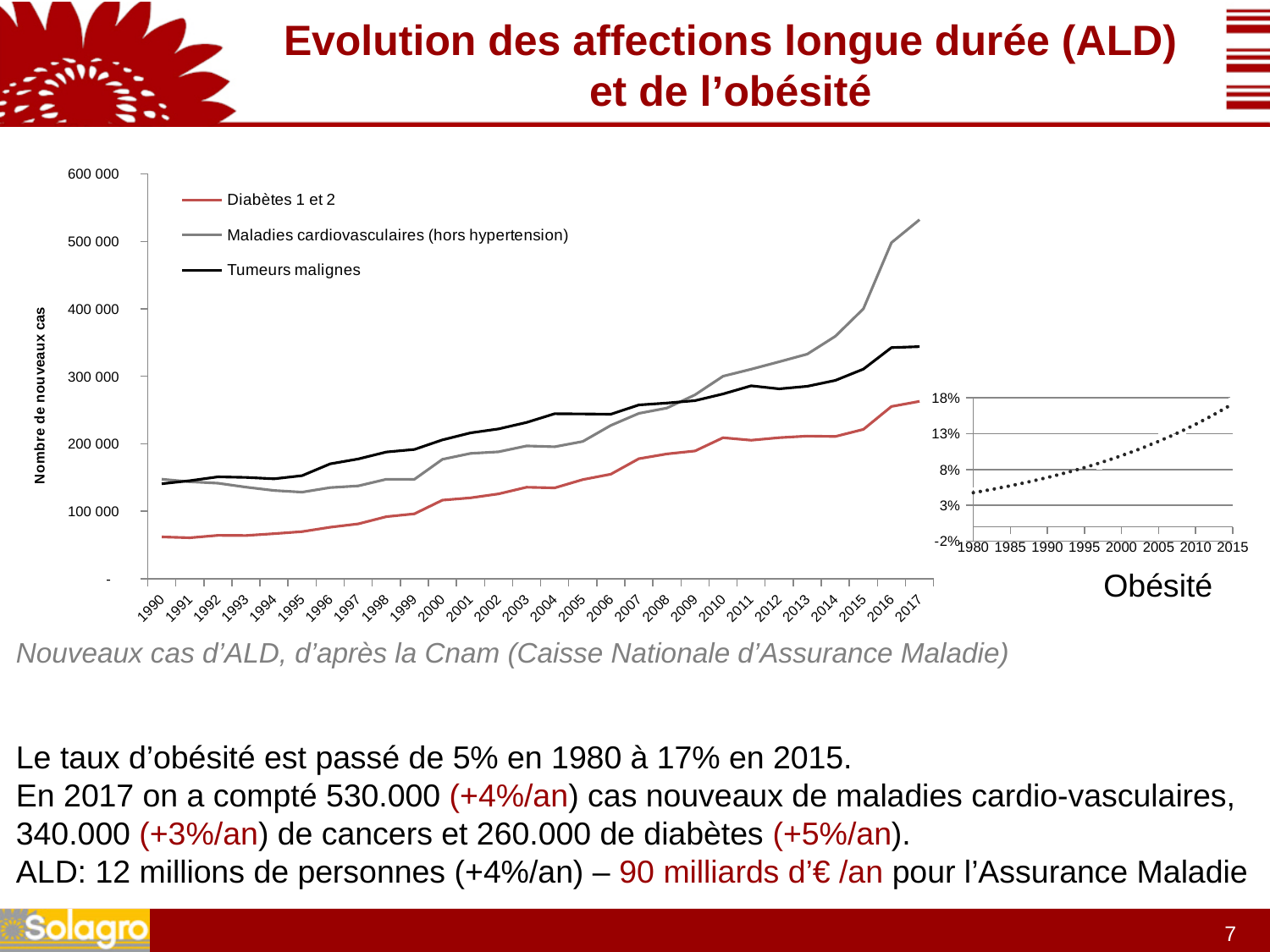
On the large chart on the left, what kind of chart is it? Line chart On the large chart on the left, is the value for Diabètes 1 et 2 in 1990 greater or less than 100 000? less On the large chart on the left, how many series does the legend list? 3 On the large chart on the left, how many years are shown along the x axis? 28 On the large chart on the left, which series has the lowest value in 2017? Diabètes 1 et 2 On the large chart on the left, does the Diabètes 1 et 2 series rise or fall from 1990 to 2017? Rise On the small Obésité chart on the right, is the value in 2015 greater or less than 13%? greater On the large chart on the left, which series has the highest value in 2017? Maladies cardiovasculaires (hors hypertension) On the large chart on the left, in 1990, which is larger: Tumeurs malignes or Diabètes 1 et 2? Tumeurs malignes On the large chart on the left, is the value for Tumeurs malignes in 2017 greater or less than 300 000? greater On the large chart on the left, what is the label of the vertical axis? Nombre de nouveaux cas